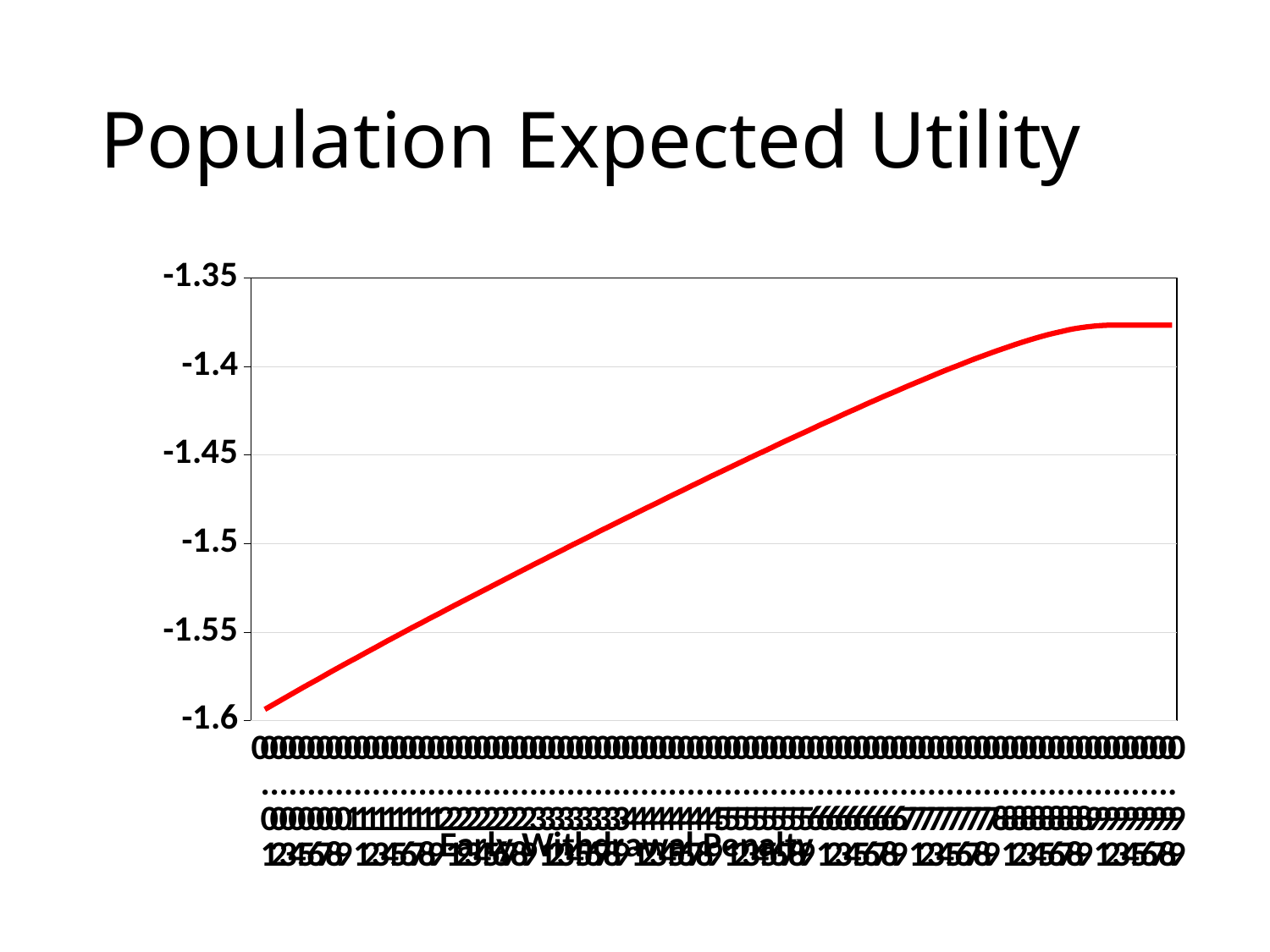
Which is larger, the value of the line at the left end of the x axis or at the right end? right end What is the label on the x axis of the chart? Early Withdrawal Penalty Is the value of the line at the right end of the x axis greater or less than -1.35? less What kind of chart is shown on the slide? line chart At which end of the x axis, left or right, does the line reach its highest value? right Is the value of the line at the left end of the x axis greater or less than -1.6? greater Do the values of the line rise or fall as you move from left to right along the x axis? rise Is the value of the line at the midpoint of the x axis greater or less than -1.5? greater At which end of the x axis, left or right, does the line reach its lowest value? left What is the title of the chart? Population Expected Utility